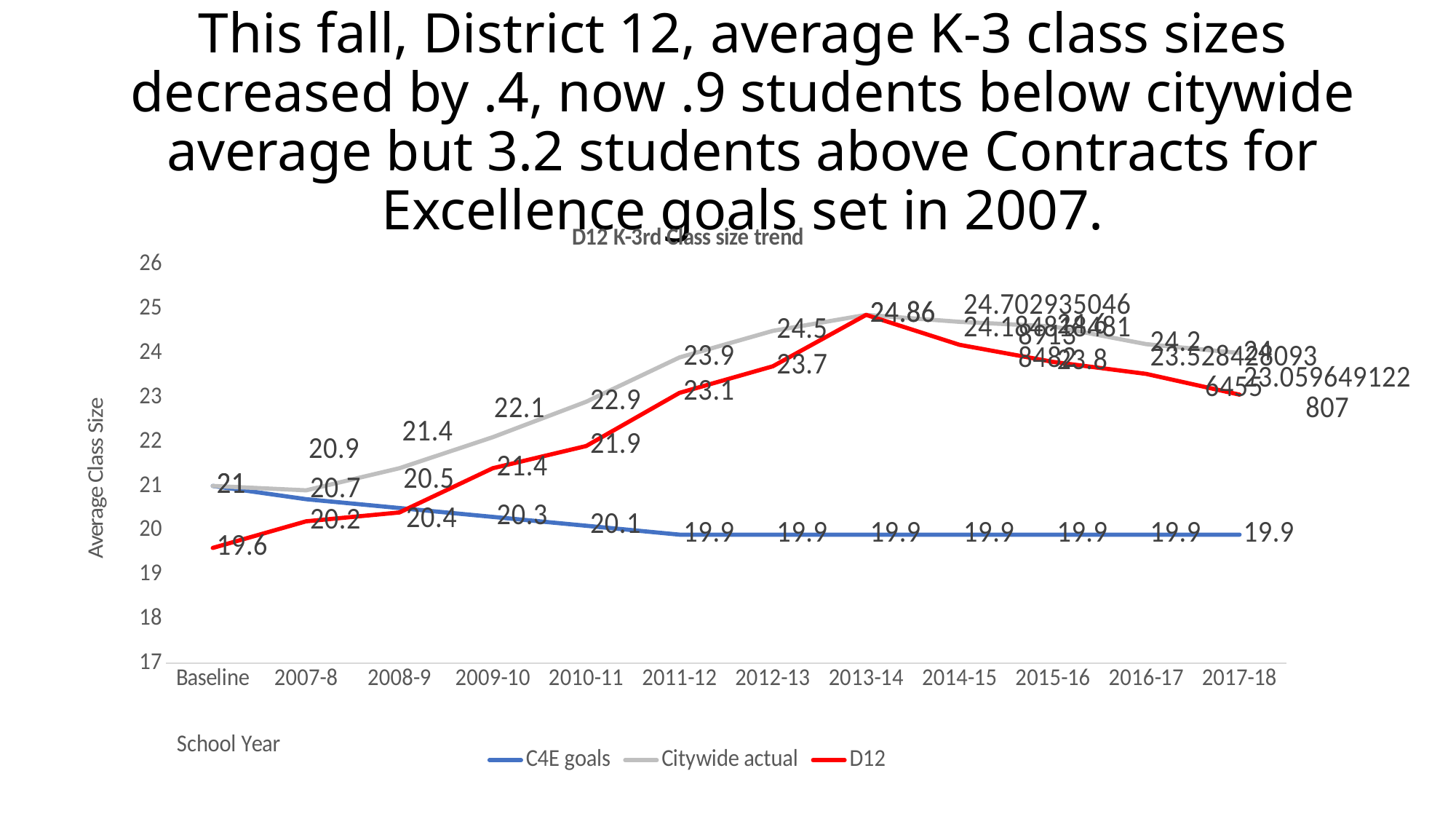
What is the D12 value for 2011-12? 23.1 What is the difference between the Citywide actual value and the D12 value in 2010-11? 1 What kind of chart is shown on the slide? Line chart In which school year does the D12 series reach its highest value? 2013-14 What is the title of the chart? D12 K-3rd Class size trend What is the D12 value at Baseline? 19.6 How many series does the chart legend list? 3 How many school-year categories are shown on the x axis? 12 In 2009-10, which is larger: the Citywide actual value or the D12 value? Citywide actual Do the C4E goals values rise or fall from Baseline to 2011-12? Fall What is the C4E goals value at Baseline? 21 What is the Citywide actual value for 2012-13? 24.5